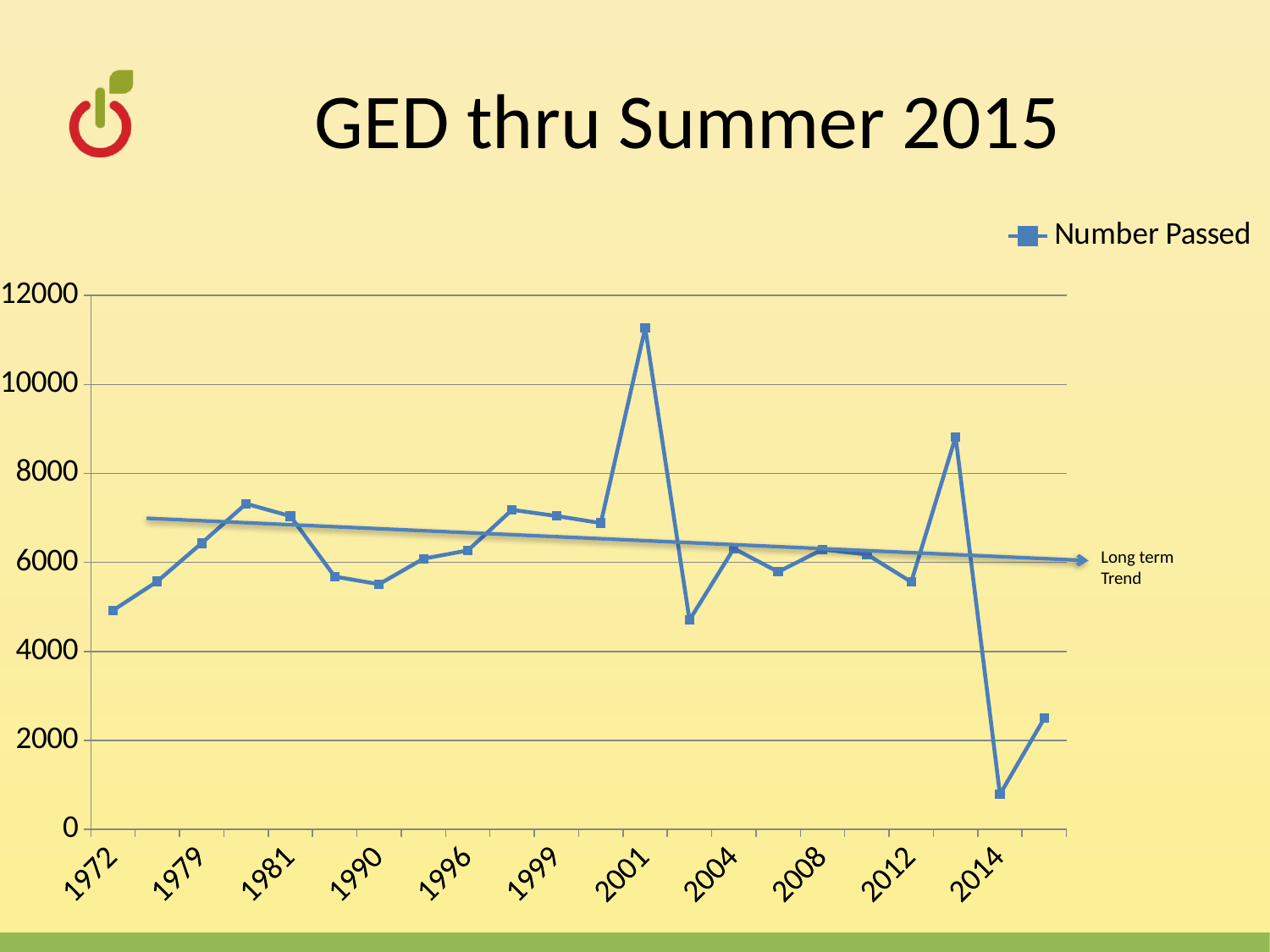
What kind of chart is shown on the slide? line chart Is the Number Passed for 2001 greater or less than 10000? greater What is the name of the series shown in the legend? Number Passed Which year has the lowest Number Passed? 2014 What is the title of the chart? GED thru Summer 2015 Is the Number Passed for 1972 greater or less than 6000? less Does the long term trend line rise or fall from left to right? fall How many series does the legend list? 1 Which year has a larger Number Passed, 2001 or 2014? 2001 Is the Number Passed for 2014 greater or less than 2000? less Which year has the highest Number Passed? 2001